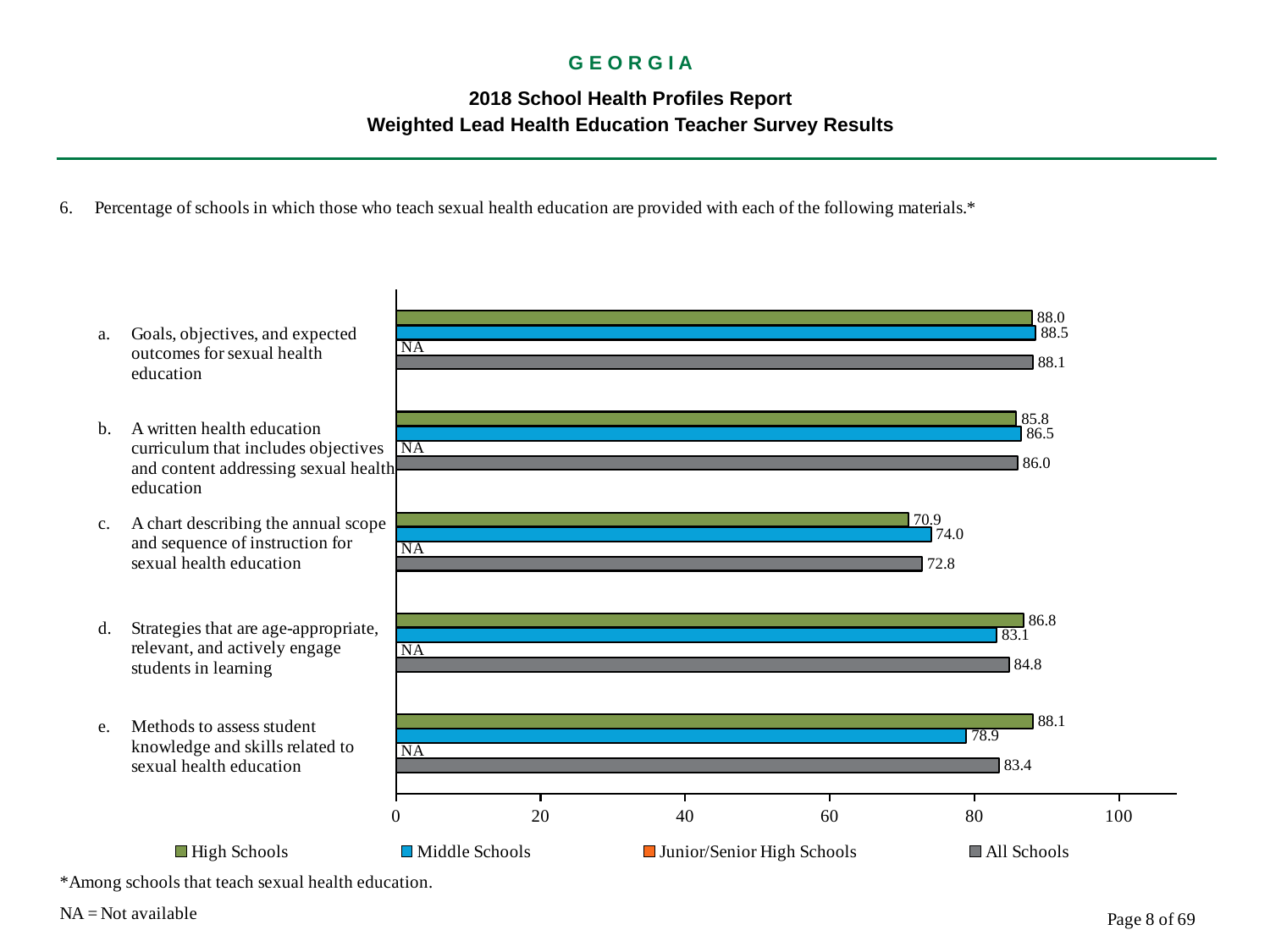
What kind of chart is shown on the slide? bar chart Which item has the highest value for Middle Schools? a. Goals, objectives, and expected outcomes for sexual health education Which item has the lowest value for All Schools? c. A chart describing the annual scope and sequence of instruction for sexual health education For item d, strategies that are age-appropriate, which is larger: the High Schools value or the Middle Schools value? High Schools What is the value for All Schools for item d, strategies that are age-appropriate, relevant, and actively engage students in learning? 84.8 What is the value for High Schools for item c, a chart describing the annual scope and sequence of instruction for sexual health education? 70.9 What is the difference between the High Schools and Middle Schools values for item e, methods to assess student knowledge and skills? 9.2 What value is shown for Junior/Senior High Schools for item a, goals, objectives, and expected outcomes? NA How many series does the legend list? 4 How many items (categories) are shown on the chart? 5 Is the Middle Schools value for item c, a chart describing the annual scope and sequence, greater or less than 80? less What is the value for Middle Schools for item e, methods to assess student knowledge and skills related to sexual health education? 78.9